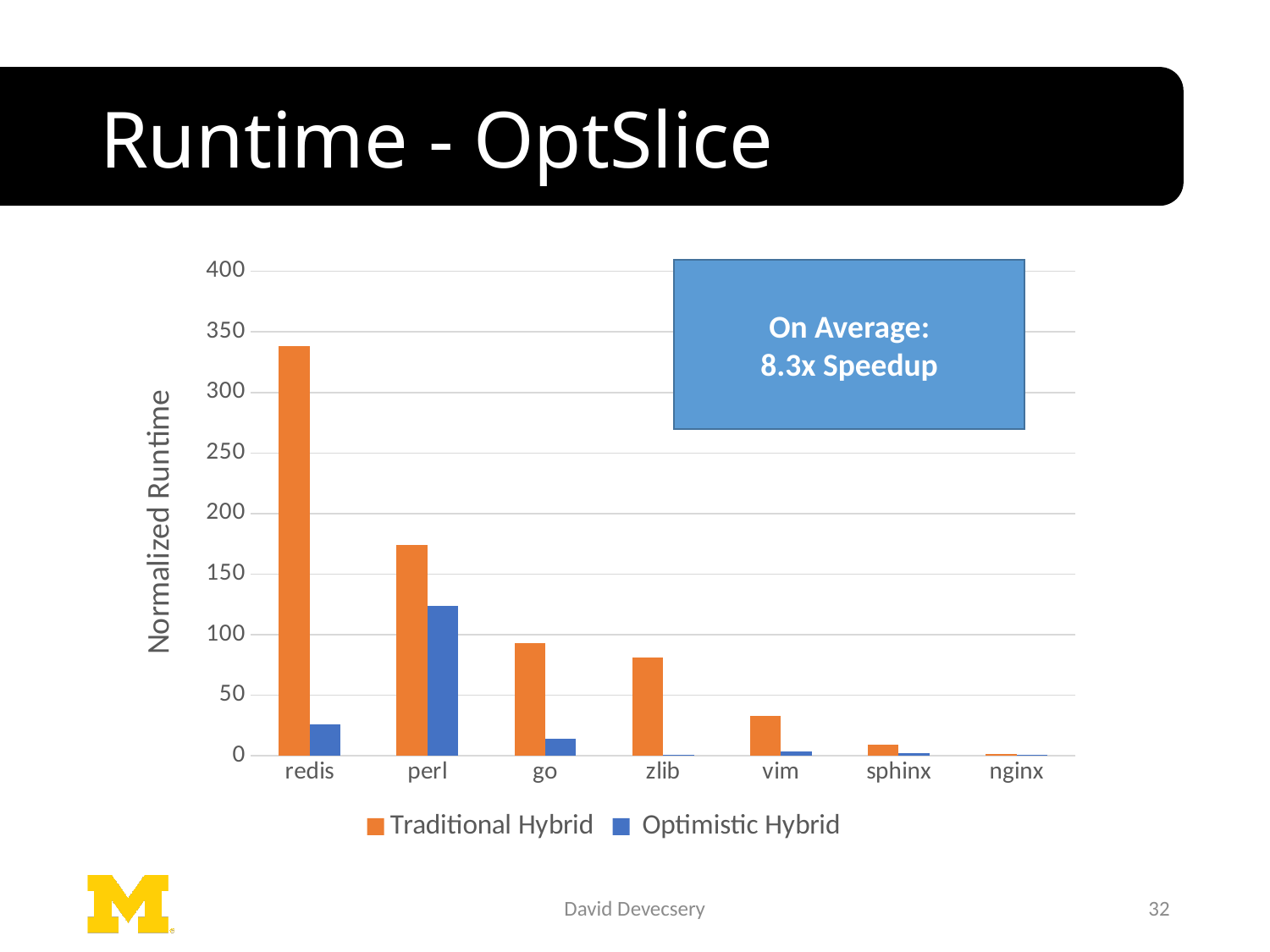
Which benchmark has the highest Optimistic Hybrid normalized runtime? perl Which benchmark has the lowest Traditional Hybrid normalized runtime? nginx Which benchmark has the highest Traditional Hybrid normalized runtime? redis What is the label on the y axis of the chart? Normalized Runtime What kind of chart is shown on the slide? bar chart Is the Optimistic Hybrid value for perl greater or less than 100? greater How many series does the legend list? 2 Is the Traditional Hybrid value for redis greater or less than 300? greater Which is larger, the Traditional Hybrid value for perl or the Traditional Hybrid value for go? perl How many benchmark categories are shown on the x axis? 7 Do the Traditional Hybrid values rise or fall moving from redis to nginx along the x axis? fall Is the Traditional Hybrid value for go greater or less than 100? less